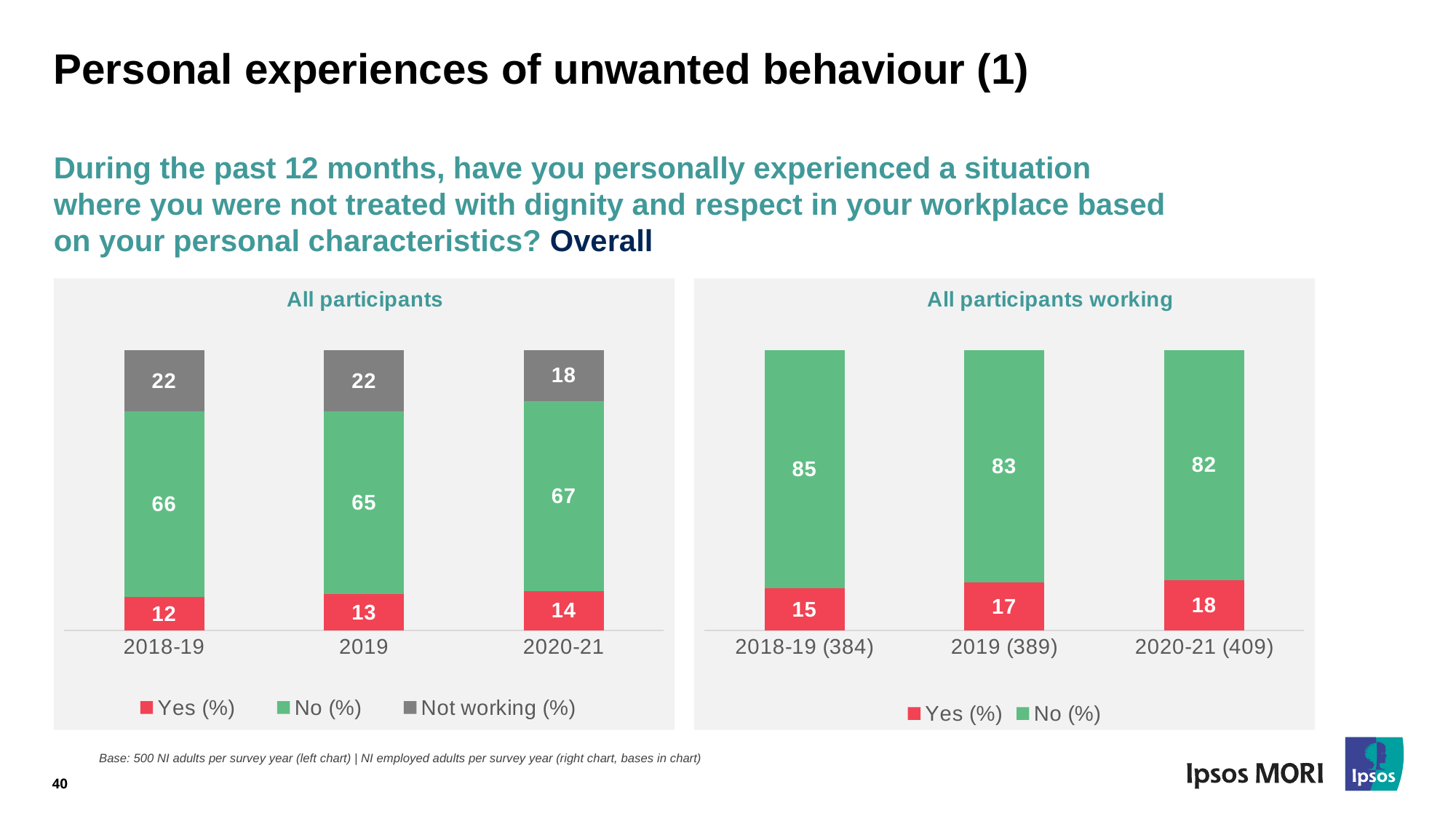
In the 'All participants working' chart, do the Yes (%) values rise or fall from 2018-19 to 2020-21? Rise How many years are shown on the x axis of the 'All participants working' chart? 3 In the 'All participants' chart, which year has the lowest Yes (%) value? 2018-19 In the 'All participants working' chart, what is the No (%) value for 2019 (389)? 83 In the 'All participants working' chart, which year has the highest Yes (%) value? 2020-21 (409) In the 'All participants' chart, is the No (%) value larger for 2019 or for 2020-21? 2020-21 In the 'All participants' chart, what is the total of the stacked bar for 2019? 100 In the 'All participants' chart, what is the Yes (%) value for 2018-19? 12 In the 'All participants' chart, what is the Not working (%) value for 2020-21? 18 In the 'All participants working' chart, what is the difference between the No (%) values for 2018-19 (384) and 2020-21 (409)? 3 What kind of chart is the 'All participants working' chart? Stacked bar chart How many series does the legend of the 'All participants' chart list? 3